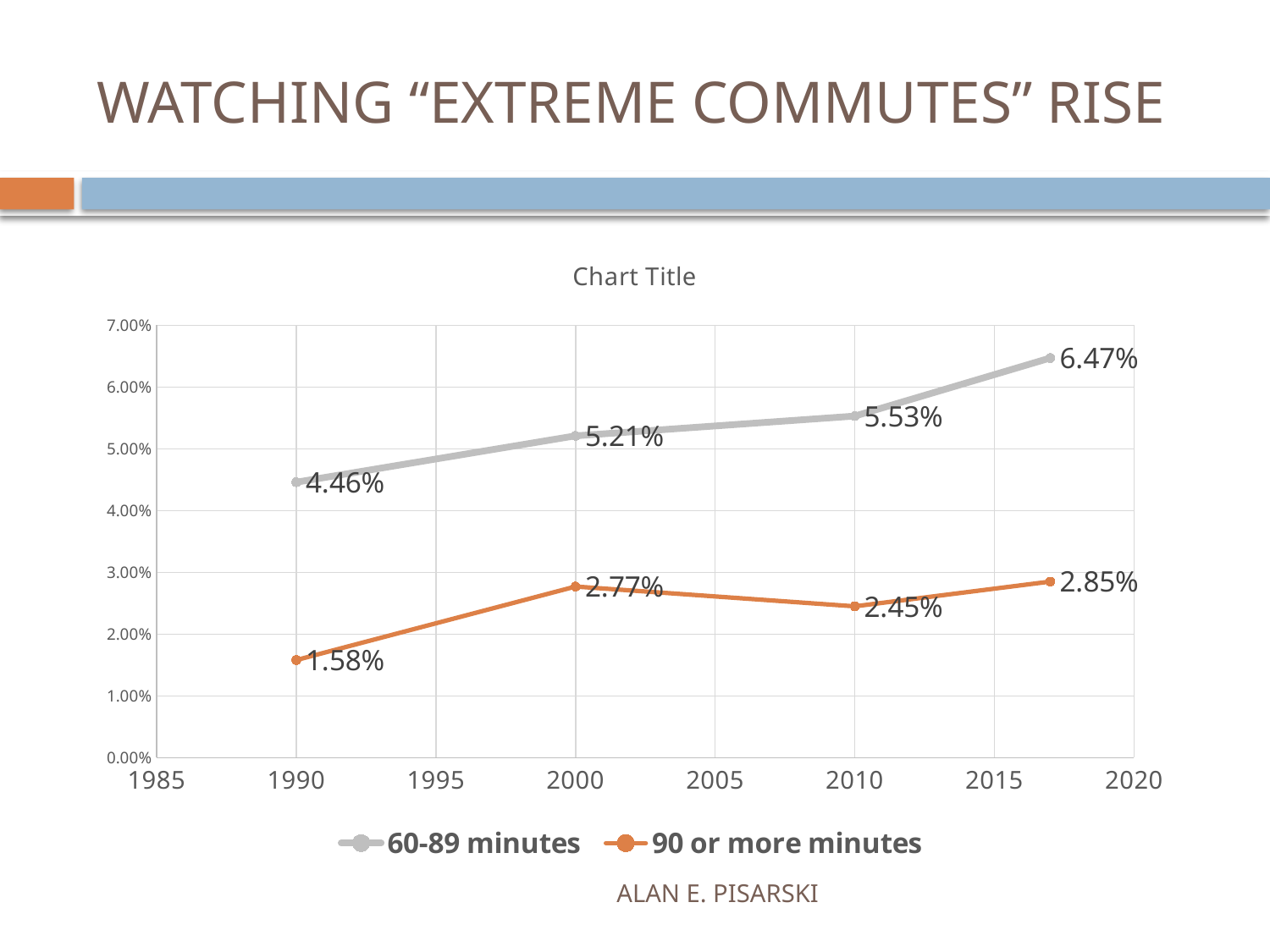
What is the highest value plotted for the 60-89 minutes series? 6.47% By how many percentage points did the 60-89 minutes series increase from 1990 to 2010? 1.07 percentage points What kind of chart is shown on the slide? Line chart Does the 60-89 minutes series rise or fall from 1990 to its last point? Rises What is the value for the 90 or more minutes series in 2010? 2.45% In 2000, which series has the higher value, 60-89 minutes or 90 or more minutes? 60-89 minutes What is the difference between the 90 or more minutes values in 2000 and 2010? 0.32 percentage points What is the value for the 60-89 minutes series in 2000? 5.21% What is the lowest value plotted for the 90 or more minutes series? 1.58% What is the value for the 60-89 minutes series in 1990? 4.46% How many series does the legend list? 2 How many data points are plotted for each series? 4